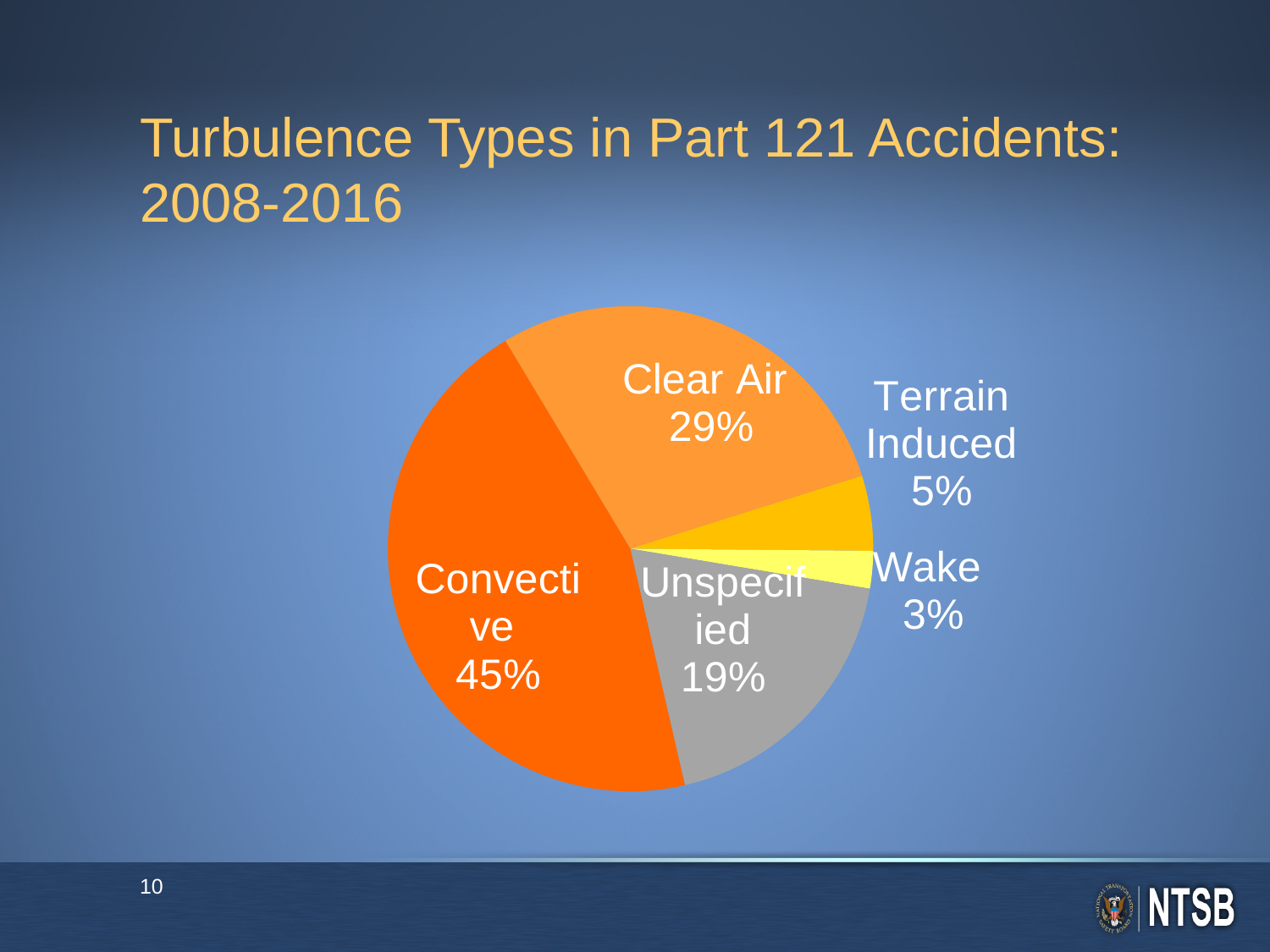
What is the difference in percentage points between Convective and Clear Air turbulence? 16 What share of the pie does Convective turbulence account for? 45% What kind of chart is shown on the slide? Pie chart What percentage is shown for Wake turbulence? 3% What percentage is shown for Clear Air turbulence? 29% What percentage is shown for Terrain Induced turbulence? 5% Which turbulence type has the largest share of the pie? Convective What percentage is shown for Unspecified turbulence? 19% Which has a larger share, Unspecified or Clear Air turbulence? Clear Air Which turbulence type has the smallest share of the pie? Wake What is the title of the chart on the slide? Turbulence Types in Part 121 Accidents: 2008-2016 How many turbulence types are shown in the pie chart? 5